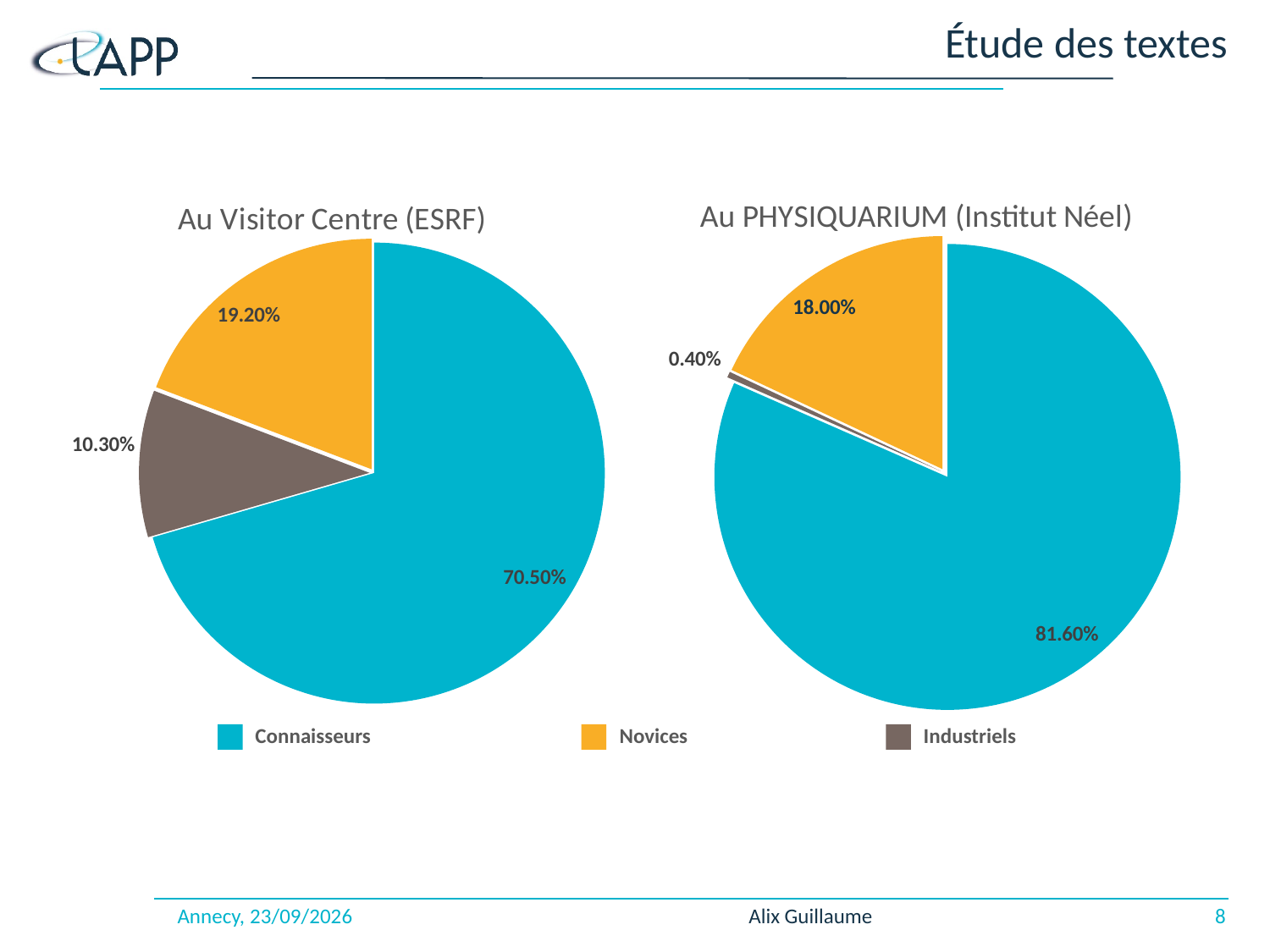
In the 'Au PHYSIQUARIUM (Institut Néel)' pie chart, which category has the smallest slice? Industriels In the 'Au Visitor Centre (ESRF)' pie chart, which category has the largest slice? Connaisseurs In the 'Au Visitor Centre (ESRF)' pie chart, what is the difference between the Novices and Industriels shares? 8.90% In the 'Au PHYSIQUARIUM (Institut Néel)' pie chart, what share do Industriels have? 0.40% What type of chart is used on this slide? Pie chart In the 'Au PHYSIQUARIUM (Institut Néel)' pie chart, what share do Connaisseurs have? 81.60% How many categories does the legend list? 3 Which chart shows a larger share for Connaisseurs, 'Au Visitor Centre (ESRF)' or 'Au PHYSIQUARIUM (Institut Néel)'? Au PHYSIQUARIUM (Institut Néel) In the 'Au Visitor Centre (ESRF)' pie chart, what share do Novices have? 19.20% In the 'Au Visitor Centre (ESRF)' pie chart, what share do Connaisseurs have? 70.50% In the 'Au PHYSIQUARIUM (Institut Néel)' pie chart, what share do Novices have? 18.00% In the 'Au Visitor Centre (ESRF)' pie chart, what share do Industriels have? 10.30%